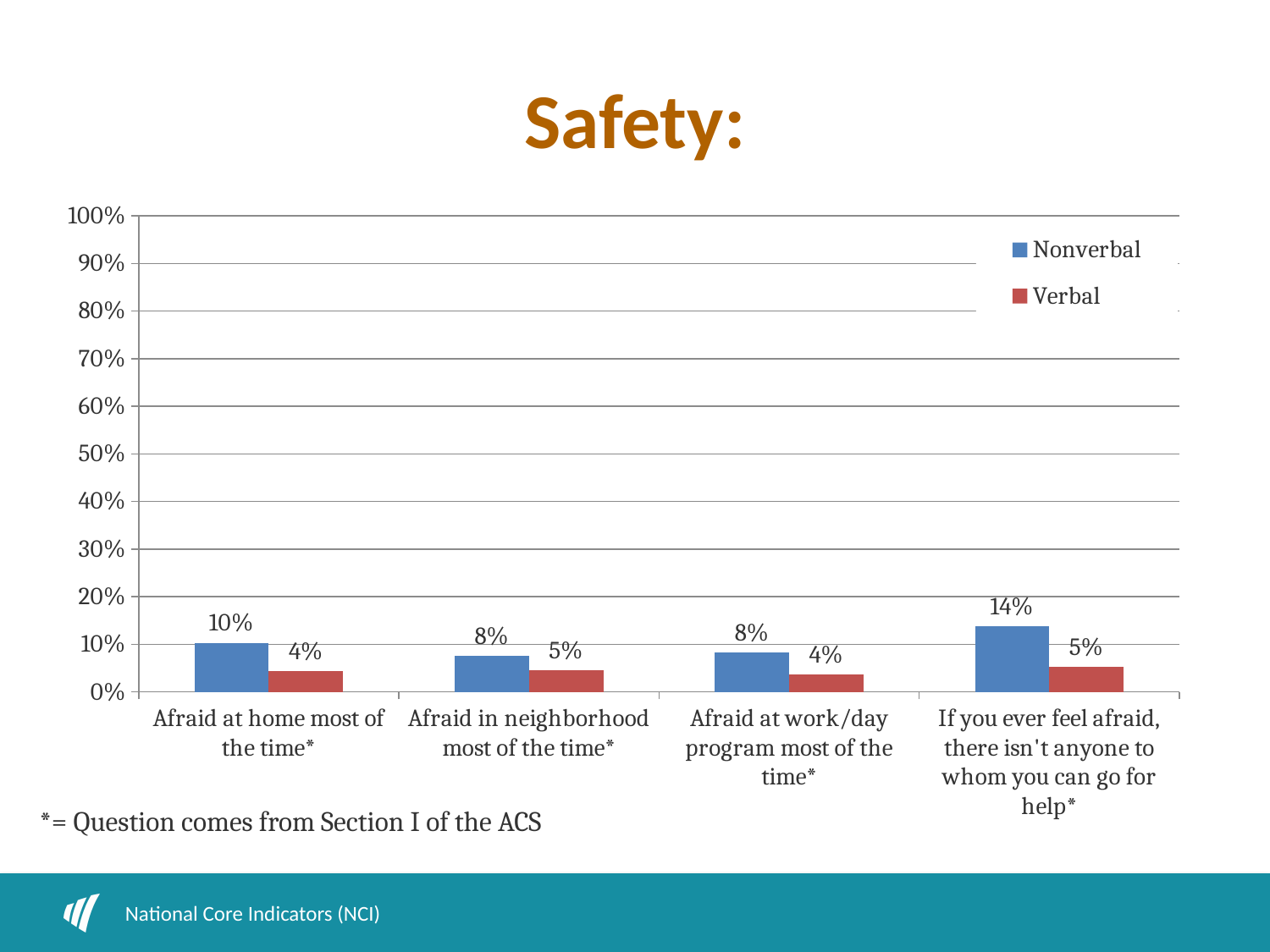
What is the Verbal value for "Afraid at work/day program most of the time*"? 4% How many series does the legend list? 2 How many categories are shown on the x axis? 4 What is the Verbal value for "Afraid in neighborhood most of the time*"? 5% Which category has the lowest Nonverbal value? Afraid in neighborhood most of the time* and Afraid at work/day program most of the time* (both 8%) What is the difference between the Nonverbal and Verbal values for "Afraid at home most of the time*"? 6% What is the Nonverbal value for "Afraid at home most of the time*"? 10% What is the Nonverbal value for "If you ever feel afraid, there isn't anyone to whom you can go for help*"? 14% For "Afraid at work/day program most of the time*", which is larger, the Nonverbal or the Verbal value? Nonverbal Which category has the highest Nonverbal value? If you ever feel afraid, there isn't anyone to whom you can go for help* What kind of chart is shown on the slide? Bar chart What is the difference between the Nonverbal and Verbal values for "If you ever feel afraid, there isn't anyone to whom you can go for help*"? 9%